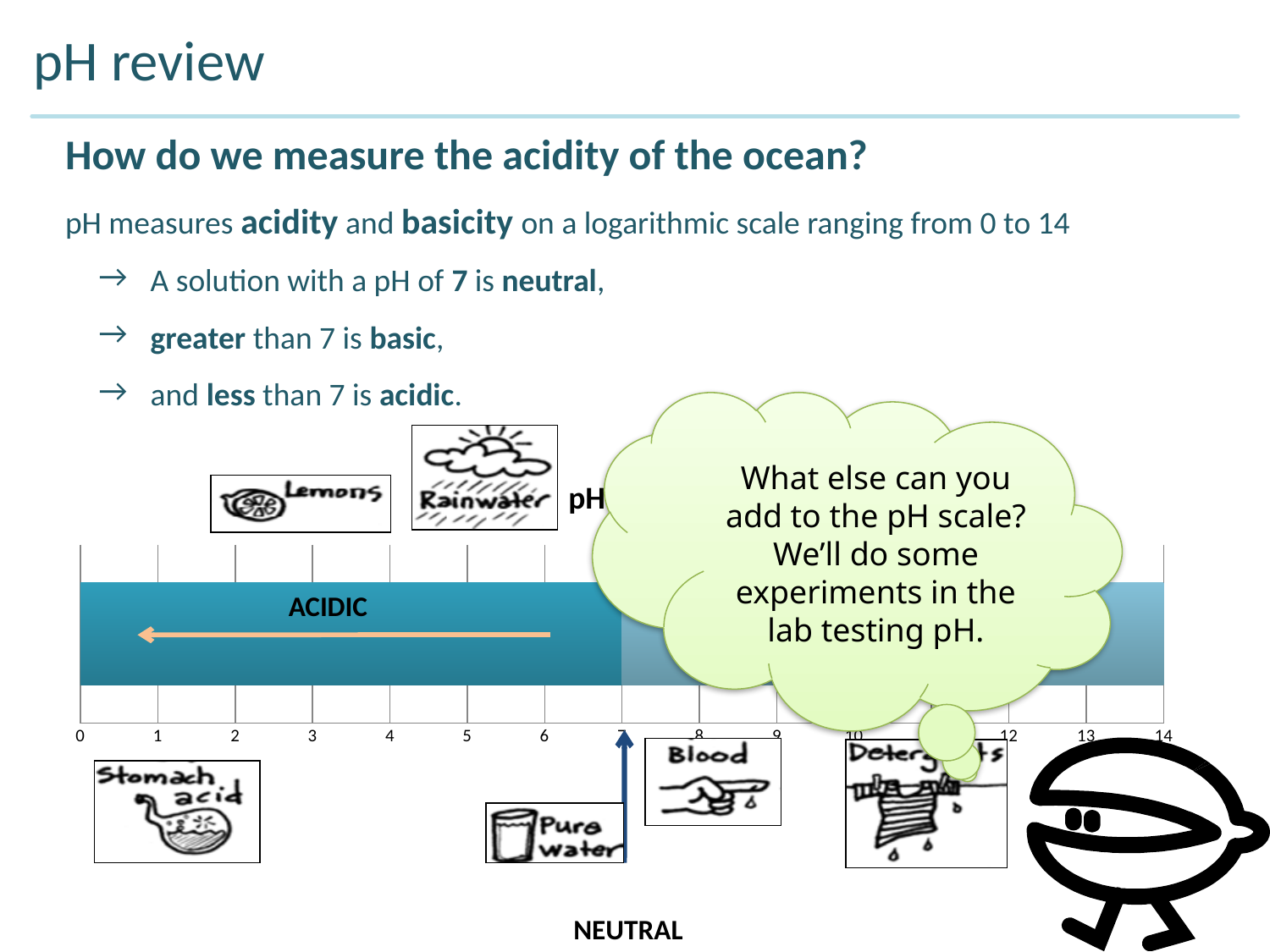
What pH value does the upward arrow labeled NEUTRAL point to on the scale? 7 What label is printed on the left (darker) portion of the pH scale bar? ACIDIC Is the position of Stomach acid on the pH scale greater or less than 7? less Is the position of Lemons on the pH scale greater or less than 7? less Is the position of Detergents on the pH scale greater or less than 7? greater What is the lowest value shown on the pH scale axis? 0 Which is placed further to the left on the pH scale, Stomach acid or Lemons? Stomach acid Which item on the pH scale is placed at the NEUTRAL arrow at pH 7? Pure water How many numbered tick labels are shown along the pH scale? 15 What is the highest value shown on the pH scale axis? 14 In which direction does the arrow inside the ACIDIC region of the scale point? Left